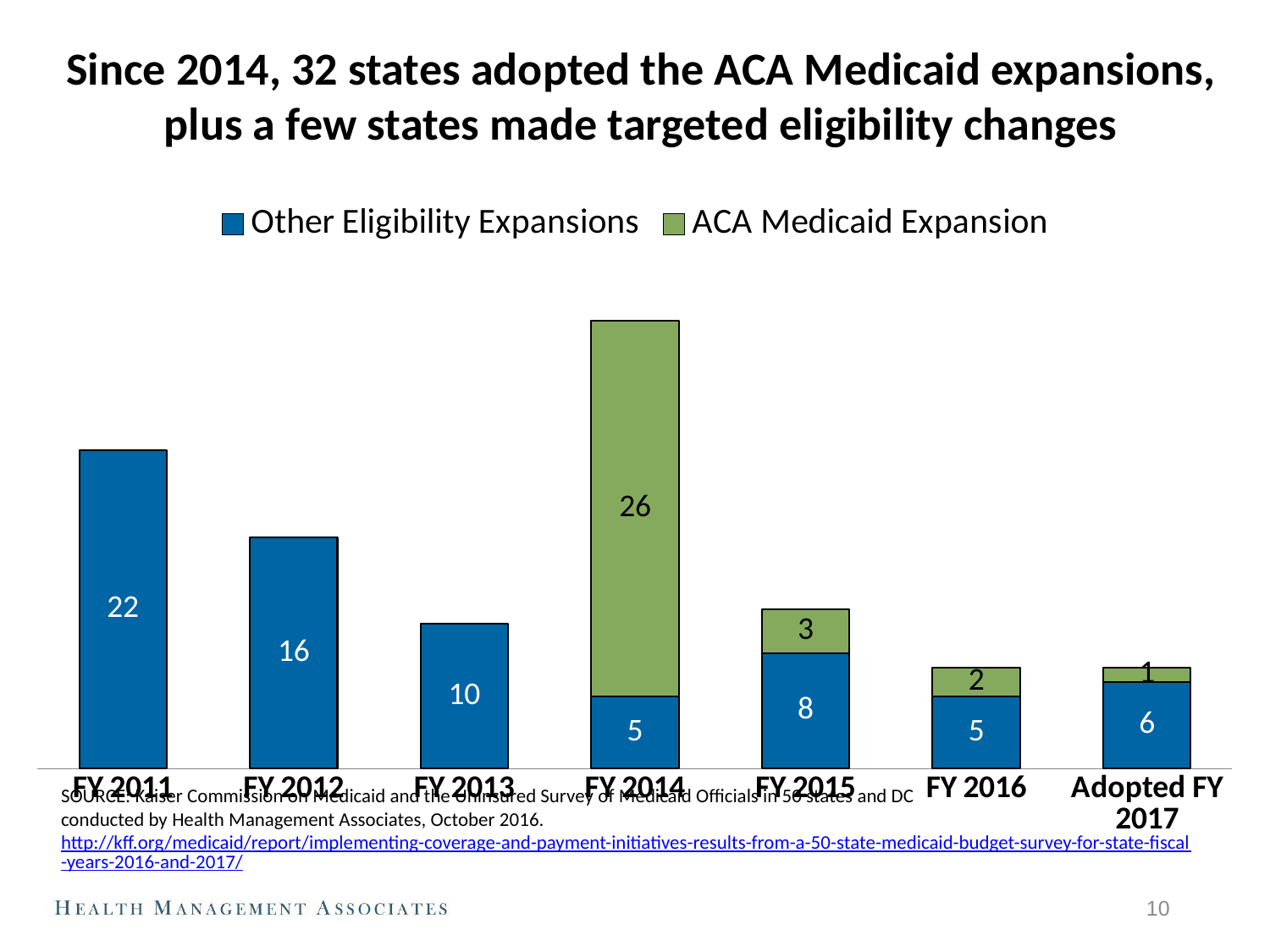
Which fiscal year has the lowest value for ACA Medicaid Expansion? Adopted FY 2017 What is the value for ACA Medicaid Expansion in Adopted FY 2017? 1 What is the value for Other Eligibility Expansions in FY 2015? 8 What is the value for Other Eligibility Expansions in FY 2011? 22 What is the value for ACA Medicaid Expansion in FY 2014? 26 What is the difference between the Other Eligibility Expansions values for FY 2011 and FY 2012? 6 How many fiscal year categories are shown on the x axis? 7 What is the total of the stacked bar for FY 2015? 11 Which fiscal year has the highest value for Other Eligibility Expansions? FY 2011 How many series does the legend list? 2 Which is larger: the ACA Medicaid Expansion value in FY 2015 or in FY 2016? FY 2015 What is the total of the stacked bar for FY 2014? 31